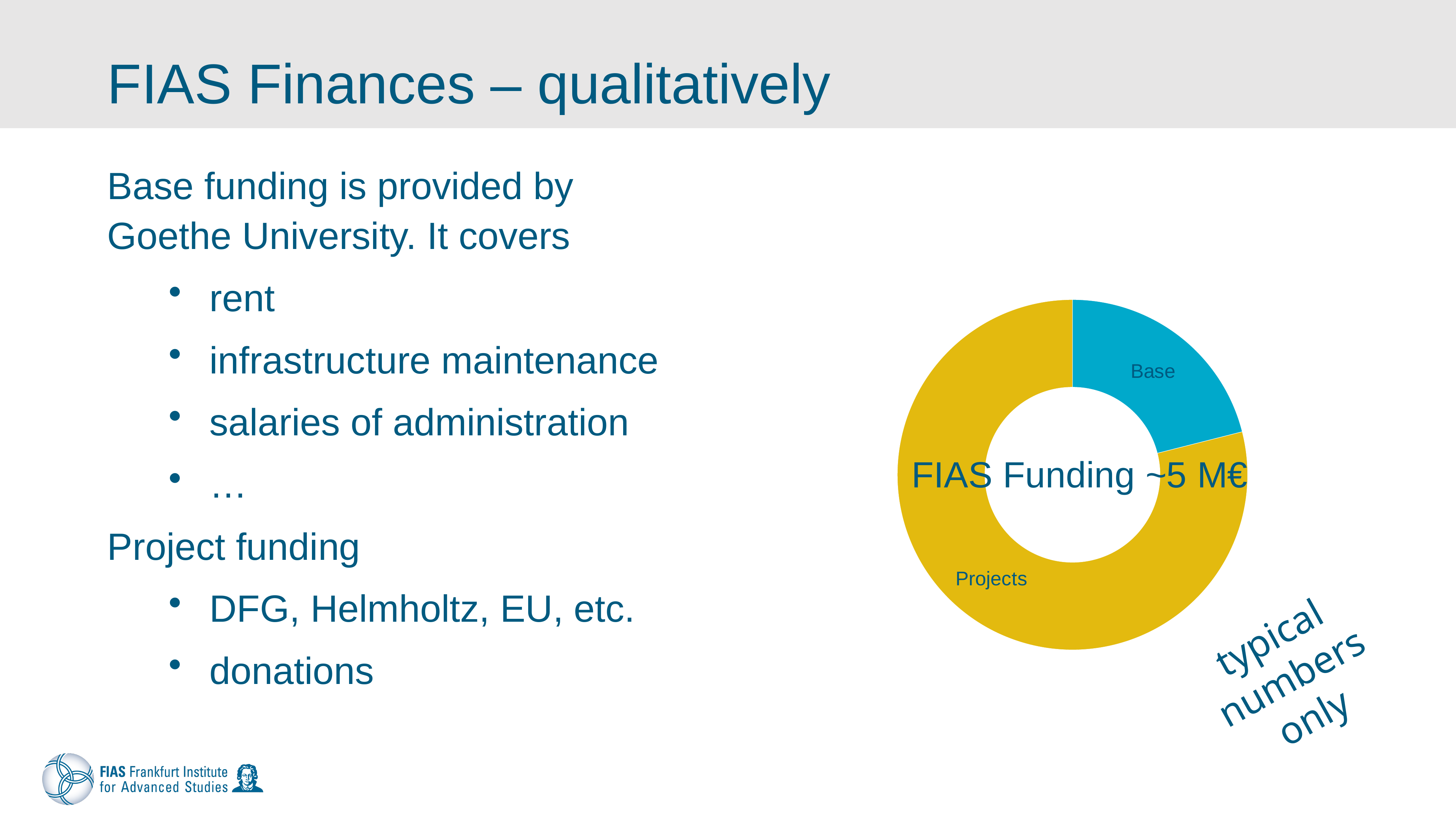
What kind of chart is shown on the slide? doughnut chart Which slice of the doughnut chart is the largest? Projects Which slice is larger in the doughnut chart, Base or Projects? Projects What text is printed in the centre of the doughnut chart? FIAS Funding ~5 M€ Which slice of the doughnut chart is the smallest? Base What colour is the Projects slice in the doughnut chart? yellow How many slices does the doughnut chart have? 2